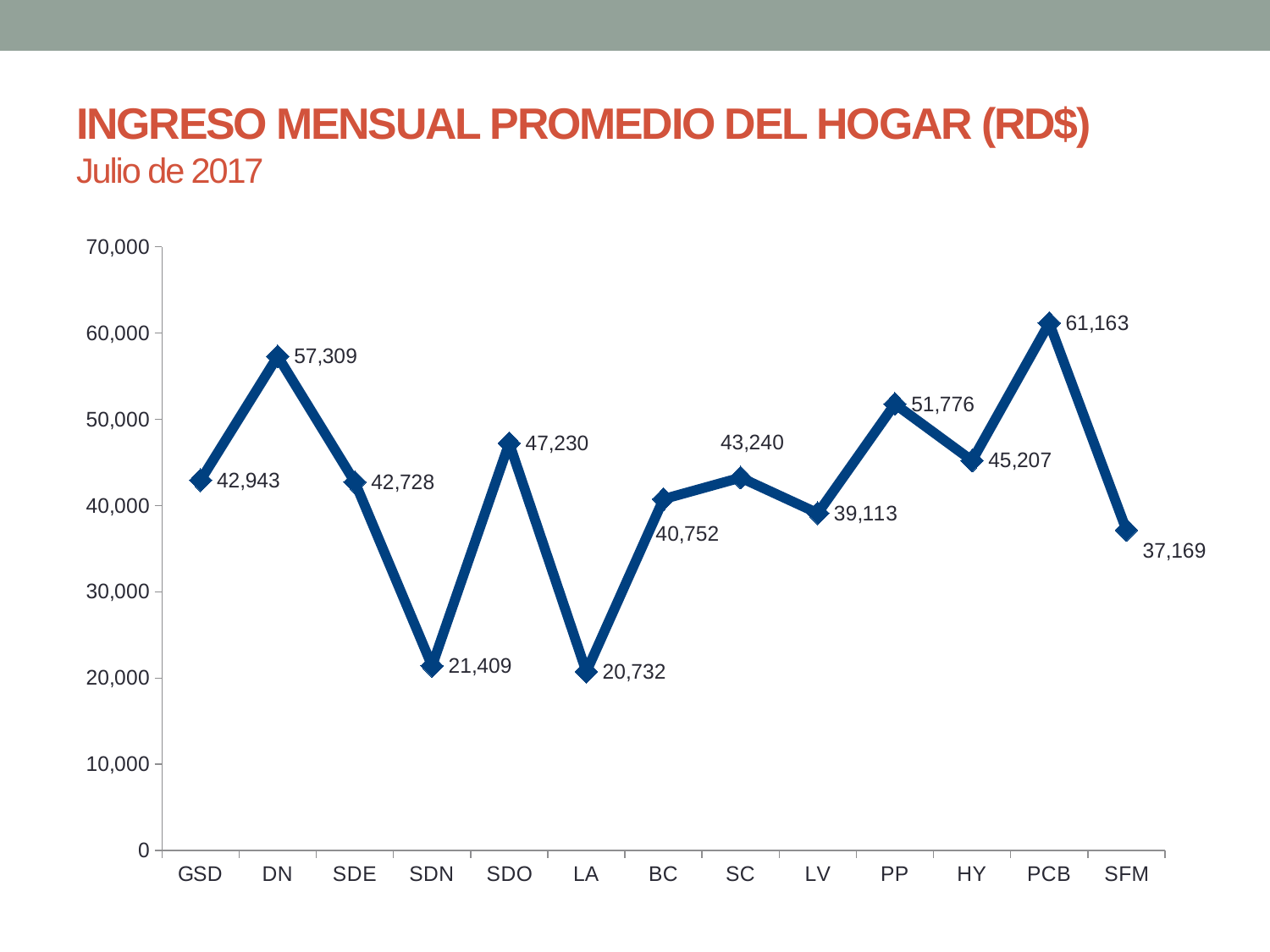
What is the title of the chart? INGRESO MENSUAL PROMEDIO DEL HOGAR (RD$) What is the value shown for PP? 51,776 Which is larger, the value for SDO or the value for SC? SDO Which category has the highest average monthly household income? PCB What is the difference between the values for PCB and SFM? 23,994 How many categories are shown on the x axis? 13 What is the difference between the values for SDN and LA? 677 Is the value for HY greater or less than 40,000? greater What is the average monthly household income for DN? 57,309 What kind of chart is shown on the slide? line chart Which category has the lowest average monthly household income? LA What is the value shown for LA? 20,732